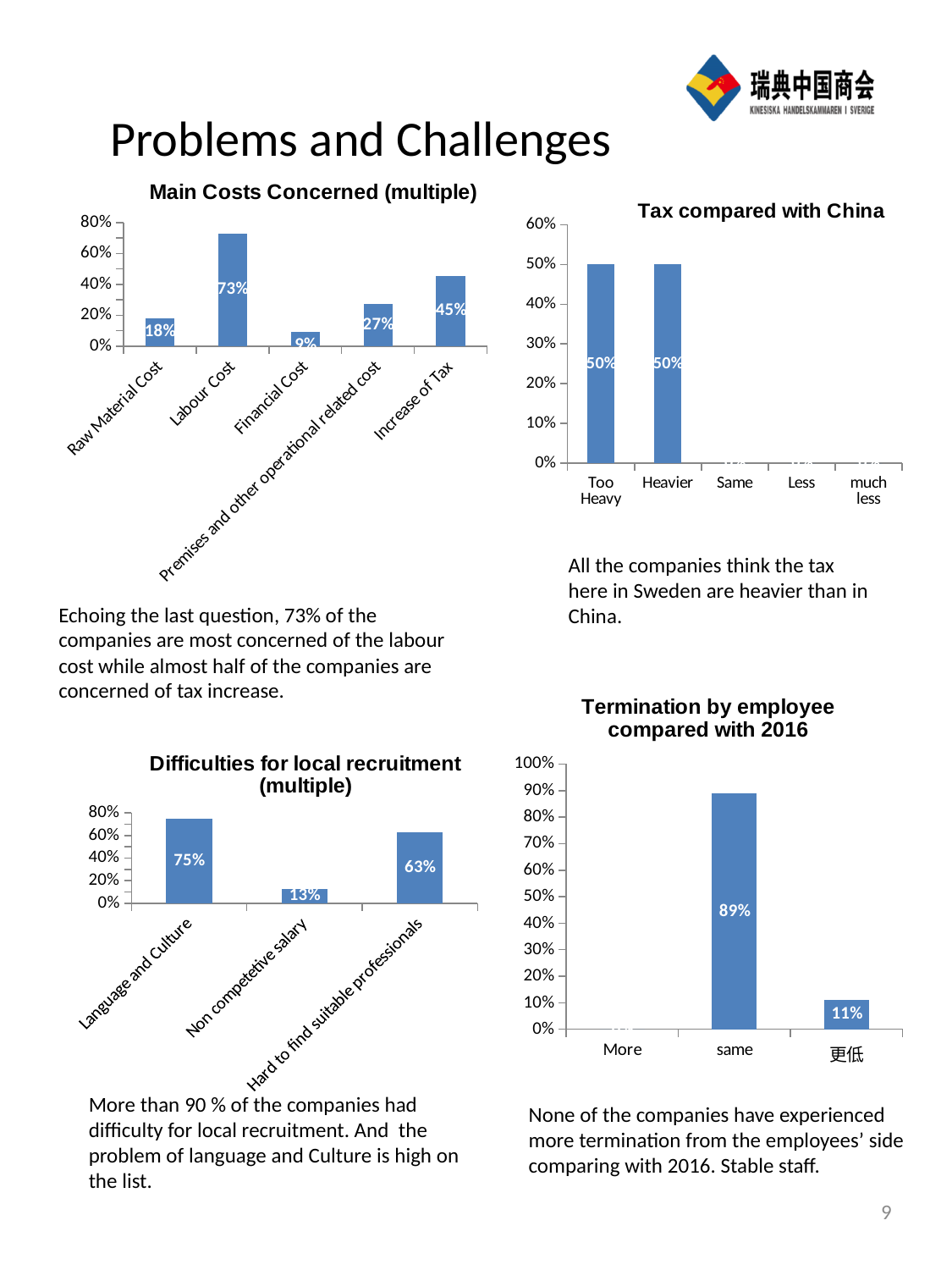
What kind of chart is 'Tax compared with China'? bar chart In the 'Main Costs Concerned (multiple)' chart, which category has the lowest value? Financial Cost In the 'Main Costs Concerned (multiple)' chart, what is the value for Labour Cost? 73% In the 'Difficulties for local recruitment (multiple)' chart, what is the value for Non competetive salary? 13% In the 'Termination by employee compared with 2016' chart, what is the difference between 'same' and '更低'? 78% In the 'Difficulties for local recruitment (multiple)' chart, which category has the highest value? Language and Culture In the 'Tax compared with China' chart, is the value for Too Heavy greater or less than 40%? greater In the 'Tax compared with China' chart, what is the value for Heavier? 50% In the 'Difficulties for local recruitment (multiple)' chart, which is larger: Language and Culture or Hard to find suitable professionals? Language and Culture In the 'Termination by employee compared with 2016' chart, what is the value for 'same'? 89% In the 'Main Costs Concerned (multiple)' chart, what is the difference between Increase of Tax and Raw Material Cost? 27% How many categories are shown in the 'Main Costs Concerned (multiple)' chart? 5